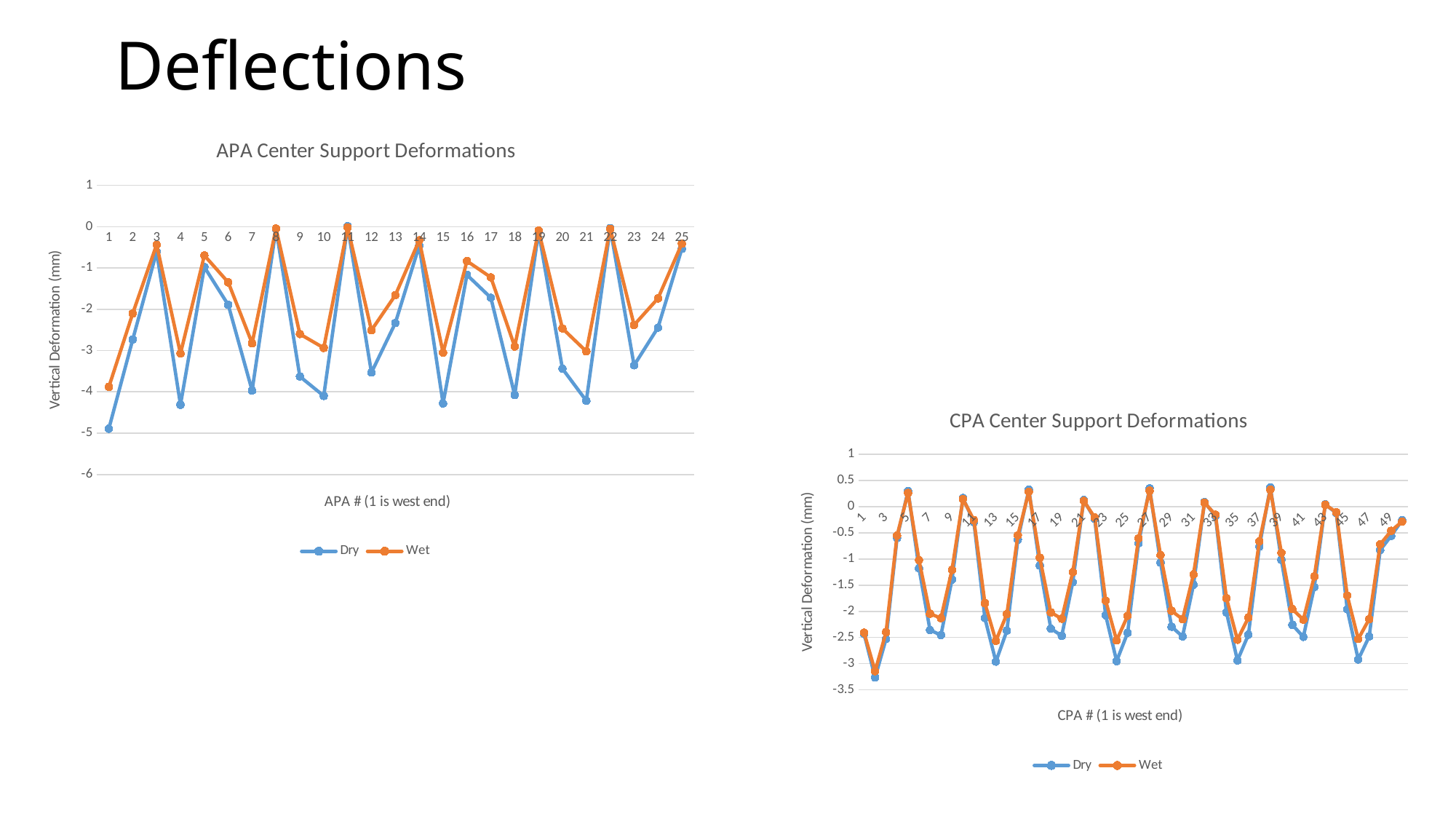
In the CPA Center Support Deformations chart, is the Dry value at CPA # 5 greater or less than 0? greater What kind of chart is the APA Center Support Deformations chart? line chart In the APA Center Support Deformations chart, at which APA # does the Dry series reach its lowest value? 1 In the APA Center Support Deformations chart, is the Dry value at APA # 1 greater or less than -4? less How many APA points are plotted on the APA Center Support Deformations chart? 25 How many series does the legend of the CPA Center Support Deformations chart list? 2 In the APA Center Support Deformations chart, is the Dry value at APA # 4 greater or less than -4? less What is the y-axis title of the CPA Center Support Deformations chart? Vertical Deformation (mm) In the CPA Center Support Deformations chart, at which CPA # does the Dry series reach its lowest value? 2 In the APA Center Support Deformations chart, at APA # 1, which series has the higher value, Dry or Wet? Wet